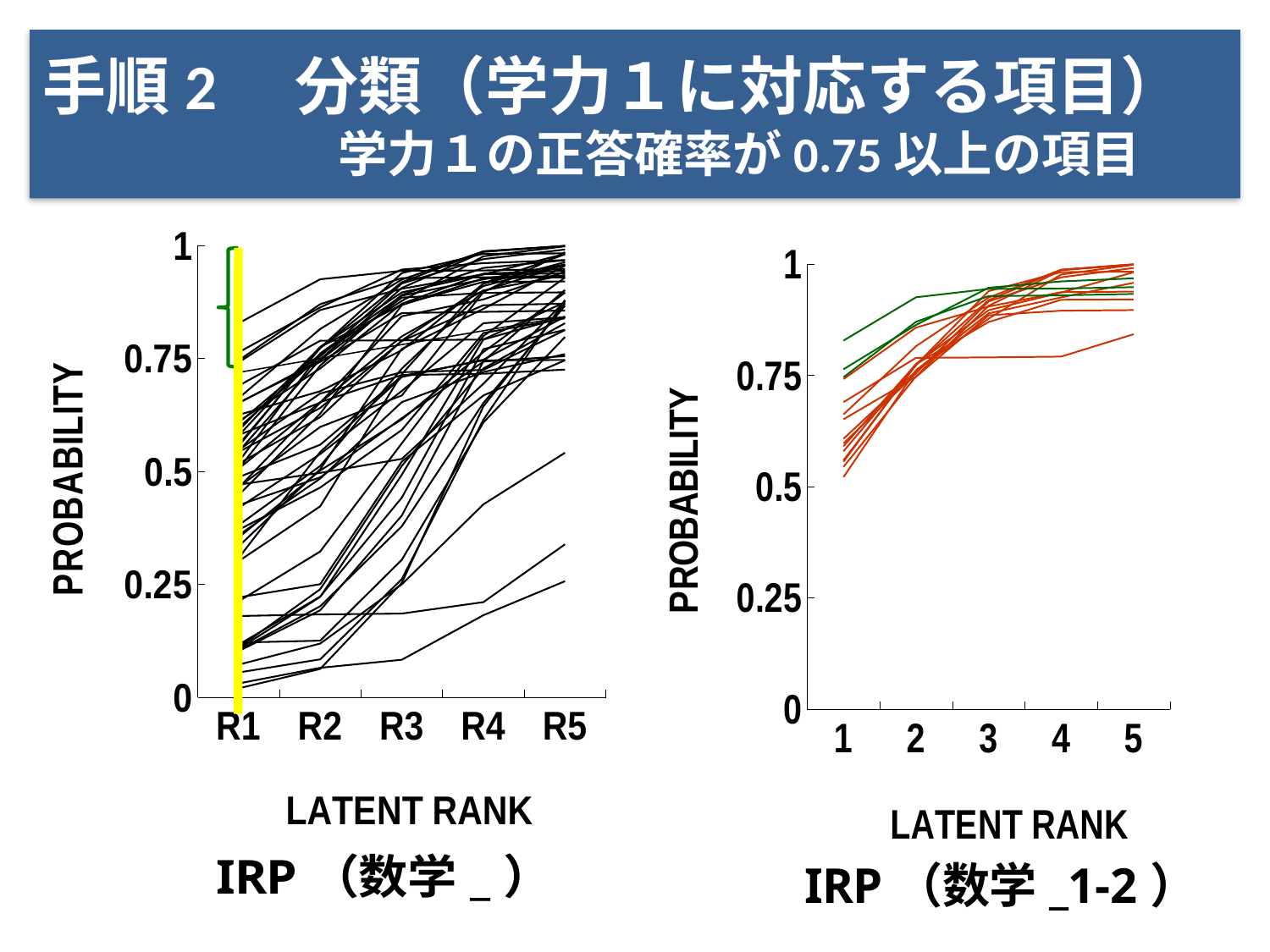
In the left chart, IRP (数学_), how many latent rank categories are shown on the x axis? 5 What kind of chart is the right chart, IRP (数学_1-2)? line chart In the right chart, IRP (数学_1-2), do the lines generally rise or fall from latent rank 1 to latent rank 5? rise In the right chart, IRP (数学_1-2), are the values of all lines at latent rank 5 greater or less than 0.75? greater What kind of chart is the left chart, IRP (数学_)? line chart In the left chart, IRP (数学_), do most lines rise or fall from R1 to R5? rise In the right chart, IRP (数学_1-2), are the values of all lines at latent rank 4 greater or less than 0.75? greater In the right chart, IRP (数学_1-2), how many latent rank points are shown on the x axis? 5 In the left chart, IRP (数学_), what is the highest tick value shown on the y axis? 1 What is the label of the y axis on the left chart, IRP (数学_)? PROBABILITY What is the label of the x axis on the right chart, IRP (数学_1-2)? LATENT RANK